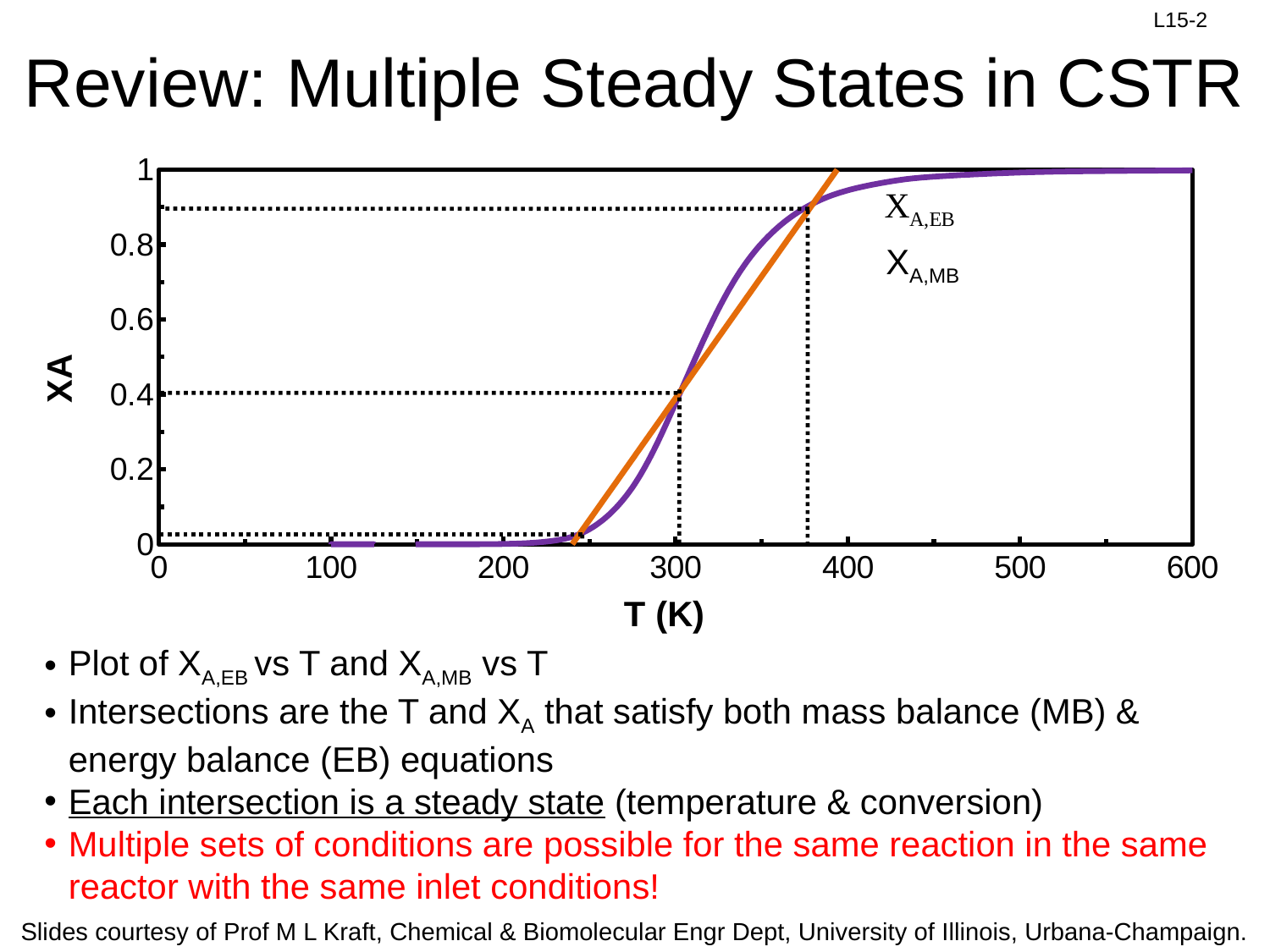
What kind of chart is shown on the slide? line chart Which series is drawn as a straight line, X_A,EB or X_A,MB? X_A,EB How many series are labelled on the chart? 2 Does the X_A,MB curve rise or fall as T increases? rise Is the value of X_A,MB at T = 500 K greater or less than 0.8? greater What is the label of the x axis of the chart? T (K) Is the value of X_A,MB at T = 100 K greater or less than 0.2? less At T = 350 K, which series has the higher value, X_A,EB or X_A,MB? X_A,MB How many intersections between the two curves are marked with dotted lines on the chart? 3 Is the value of X_A,EB at T = 350 K greater or less than 0.6? greater